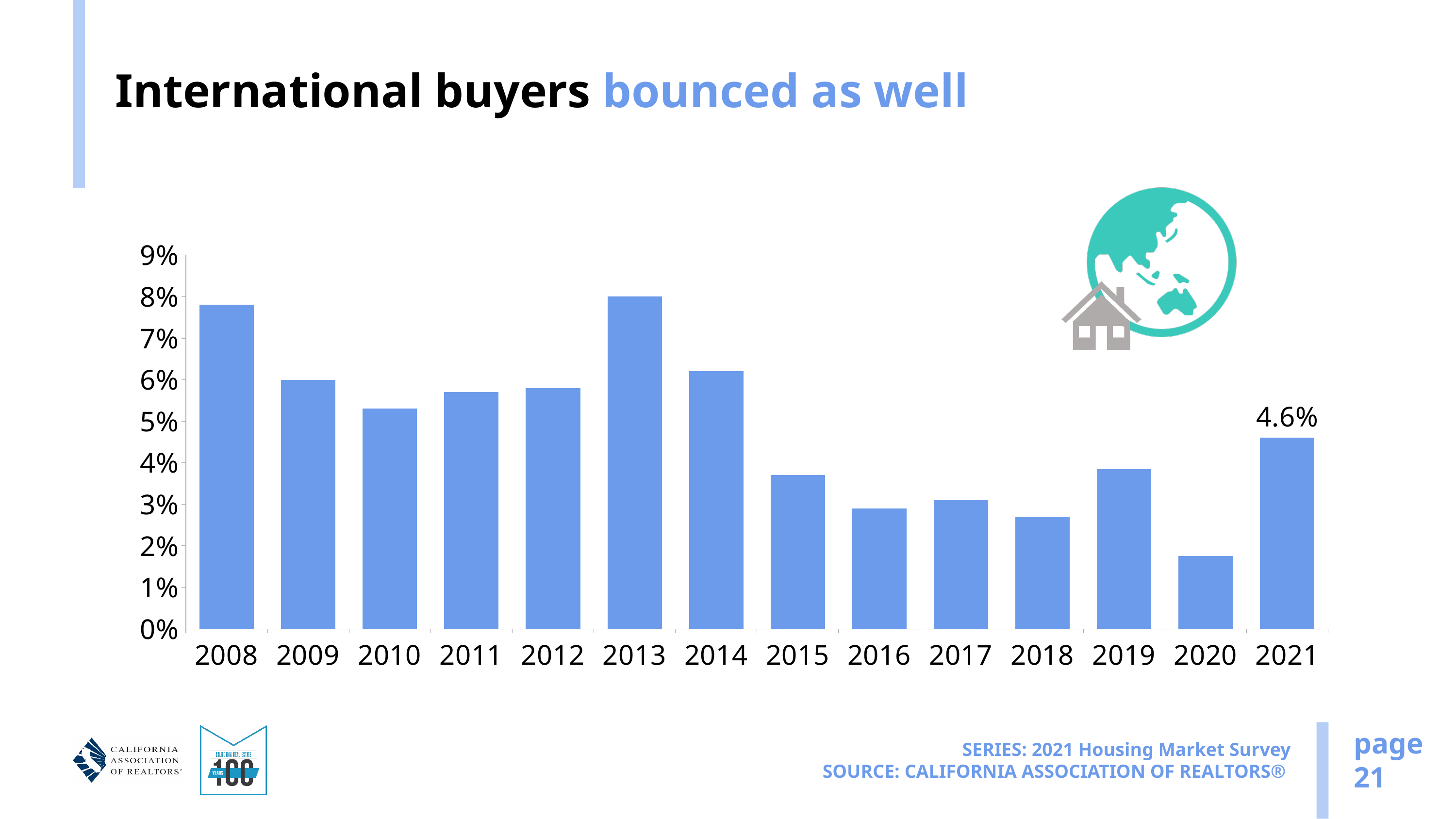
Is the value for 2020 greater or less than 2%? less What is the value shown for 2021? 4.6% Which year has the highest bar? 2013 How many years are shown on the x axis? 14 Which year has the lowest bar? 2020 Is the value for 2015 greater or less than 4%? less What kind of chart is shown on the slide? Bar chart Is the value for 2014 greater or less than 6%? greater Which year has the larger value, 2008 or 2009? 2008 Do the values generally rise or fall from 2013 to 2020? Fall Which year has the larger value, 2017 or 2018? 2017